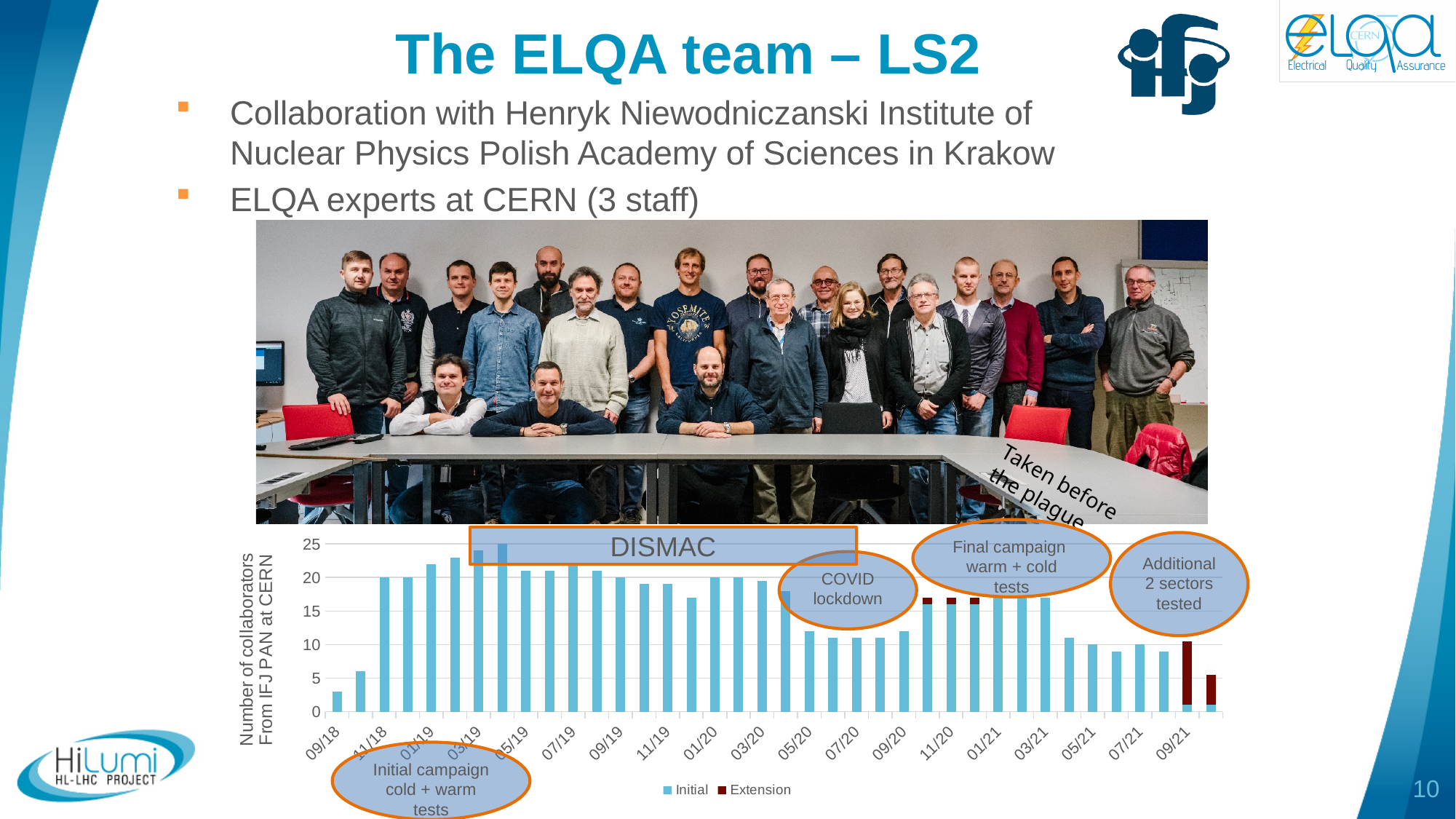
What kind of chart is shown at the bottom of the slide? bar chart Is the value for 09/18 greater or less than 5? less What are the two series named in the chart legend? Initial and Extension What is the title of the vertical axis of the chart? Number of collaborators From IFJ PAN at CERN Is the Initial value for 03/21 greater or less than 15? greater Is the Initial value for 05/20 greater or less than 10? greater Which is larger, the Initial value for 05/19 or the Initial value for 07/20? 05/19 Which is larger, the value for 09/18 or the value for 11/18? 11/18 Do the Initial values generally rise or fall from 05/19 to 09/21? fall How many series does the legend of the chart list? 2